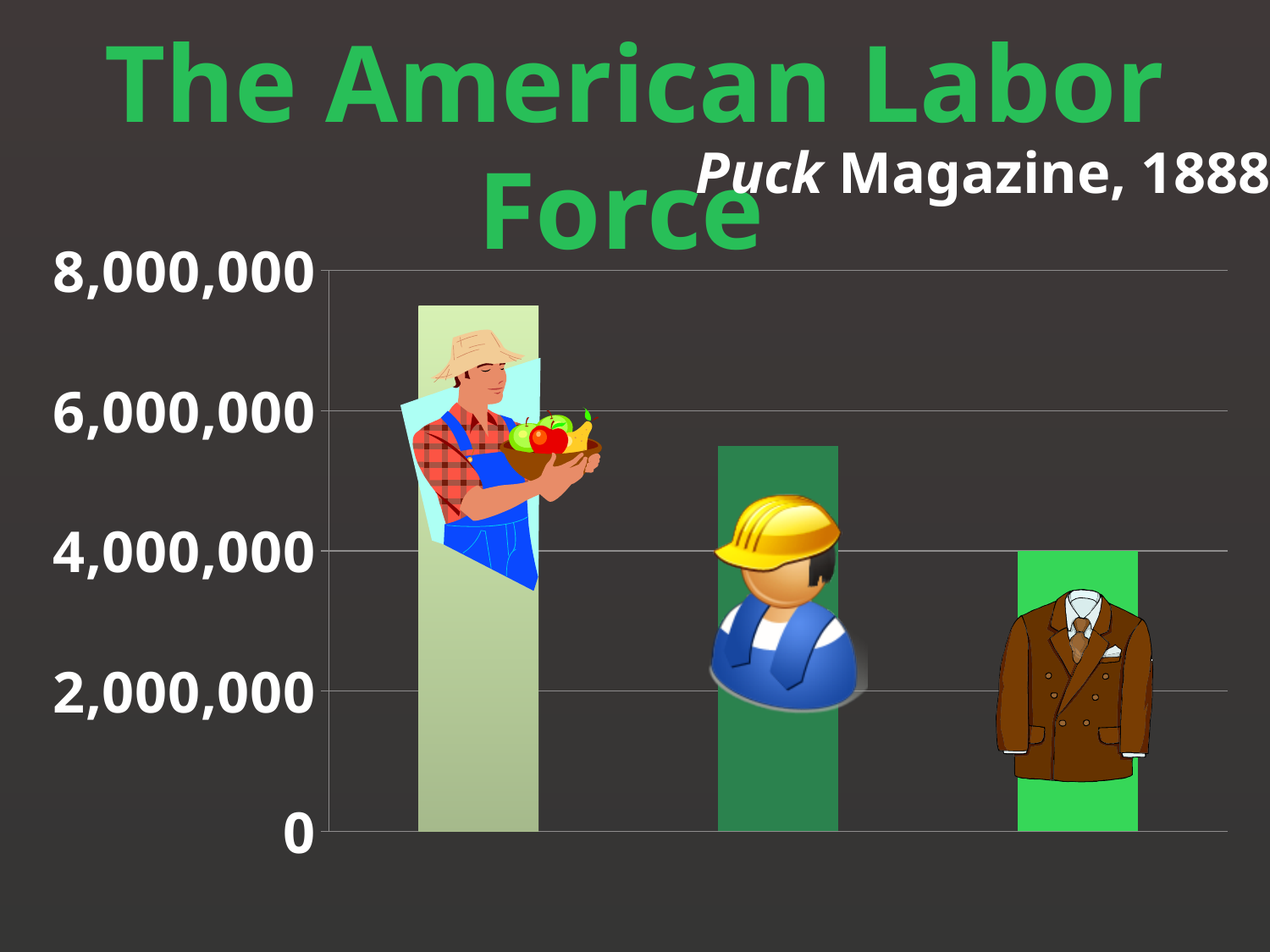
How many bars does the chart show? 3 Is the value of the rightmost bar (suit) greater or less than 6,000,000? less Do the bar values rise or fall from left to right across the chart? fall Which bar is the lowest: the left (farmer), middle (construction worker), or right (suit)? the right bar (suit) Which bar is the highest: the left (farmer), middle (construction worker), or right (suit)? the left bar (farmer) Is the value of the middle bar (construction worker) greater or less than 4,000,000? greater Is the value of the middle bar (construction worker) greater or less than 6,000,000? less Which is larger, the leftmost bar (farmer) or the middle bar (construction worker)? the leftmost bar (farmer) What is the title of the chart on the slide? The American Labor Force What is the highest value labeled on the vertical axis? 8,000,000 What kind of chart is shown on the slide? bar chart